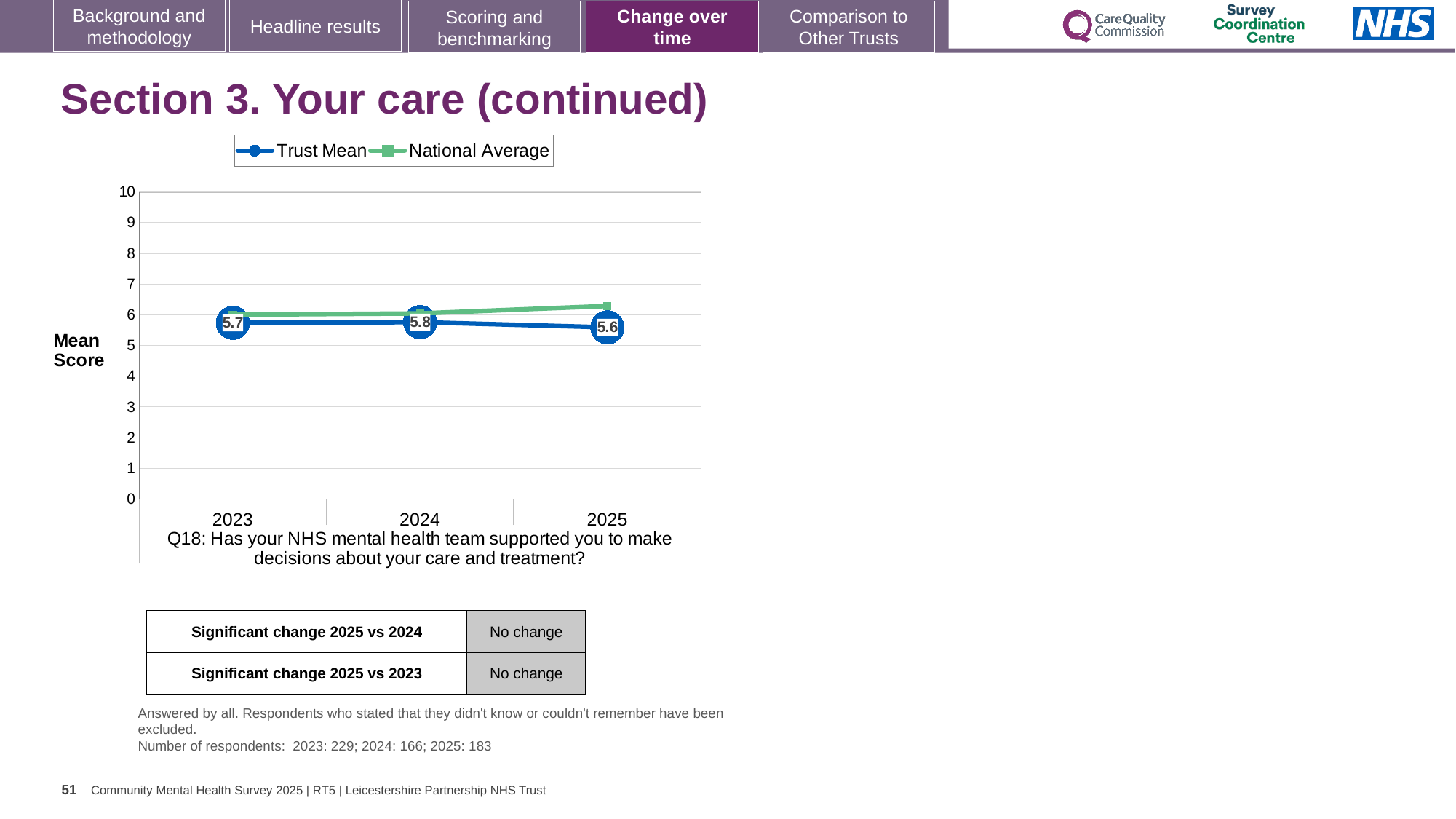
Which is larger, the Trust Mean score for 2023 or for 2025? 2023 How many years are shown on the x axis? 3 In which year is the Trust Mean score highest? 2024 Does the National Average line rise or fall from 2023 to 2025? Rise What is the Trust Mean score for 2023? 5.7 How many series does the legend list? 2 Is the National Average value for 2025 greater or less than 7? less What kind of chart is shown on the slide? Line chart What is the difference between the Trust Mean scores for 2024 and 2025? 0.2 What is the Trust Mean score for 2025? 5.6 In which year is the Trust Mean score lowest? 2025 What is the Trust Mean score for 2024? 5.8